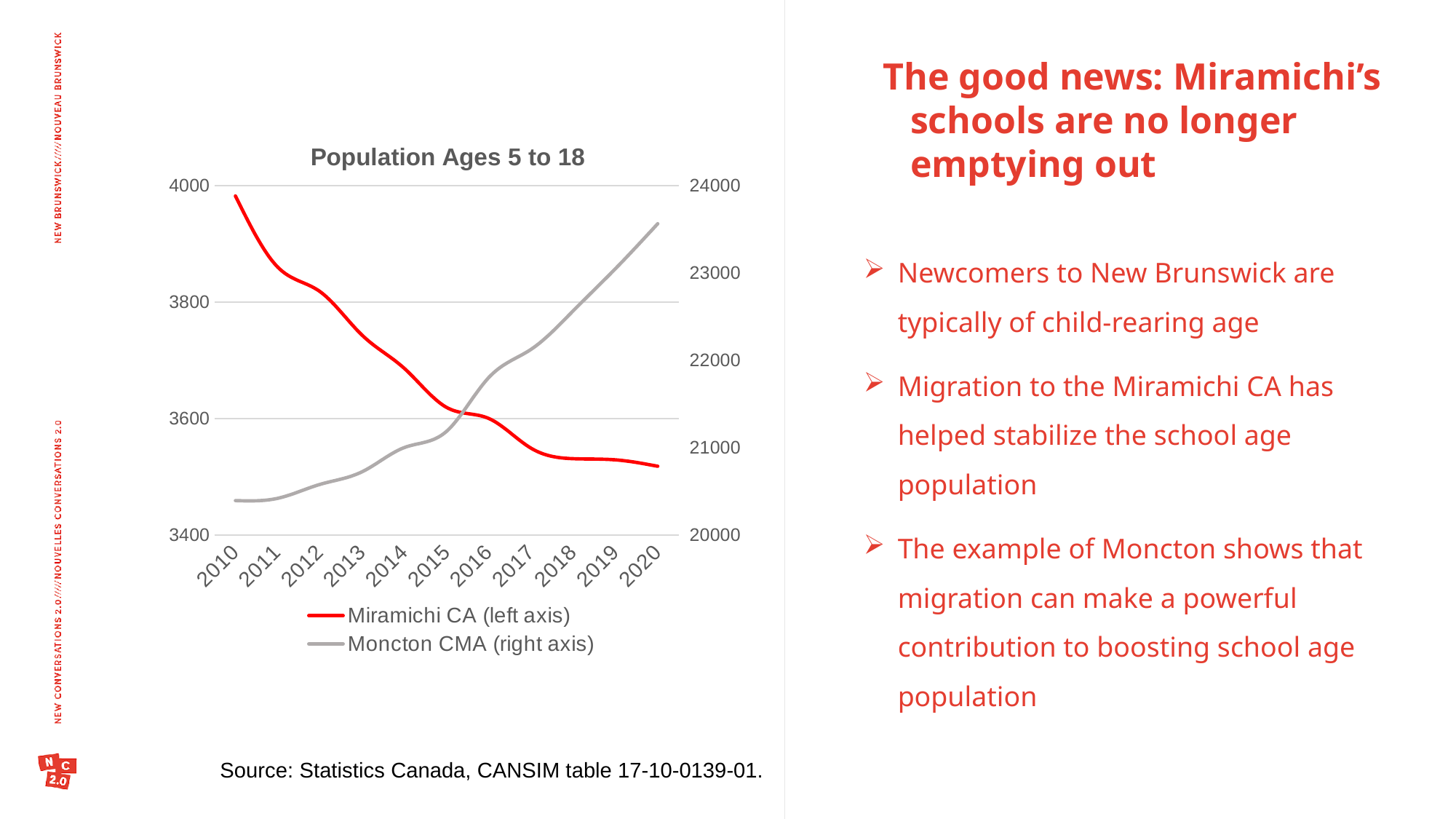
Does the Moncton CMA line rise or fall from 2010 to 2020? Rise Is the Miramichi CA value for 2020 greater or less than 3600? less How many years are plotted along the x axis of the chart? 11 Is the Moncton CMA value for 2020 greater or less than 23000? greater What kind of chart is shown on the slide? Line chart What is the title of the chart? Population Ages 5 to 18 How many series does the chart's legend list? 2 Which series is plotted against the right axis? Moncton CMA Is the Miramichi CA value for 2010 greater or less than 3800? greater Does the Miramichi CA line rise or fall from 2010 to 2020? Fall In which year is the Miramichi CA value highest? 2010 In which year is the Moncton CMA value lowest? 2010